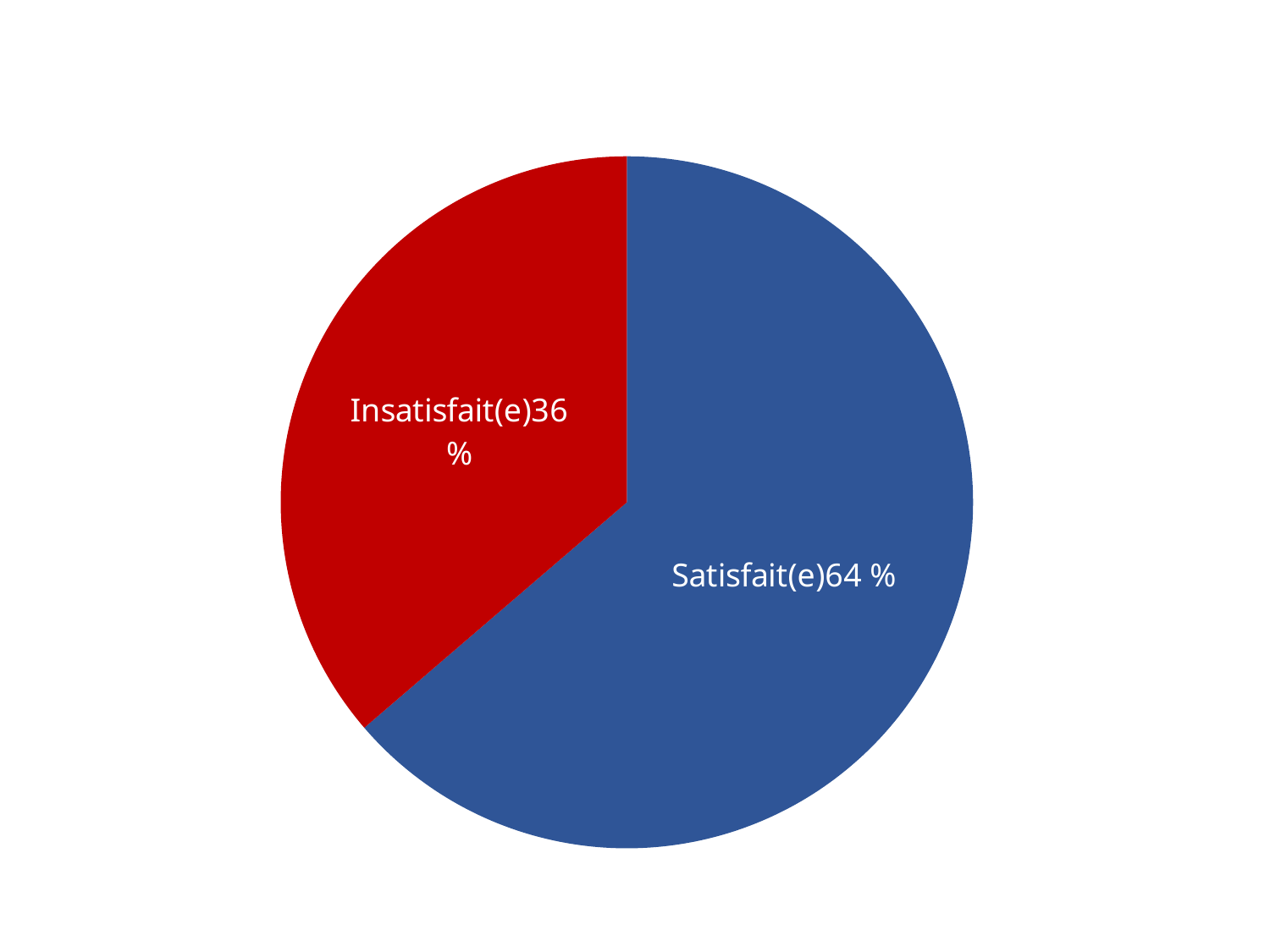
What share of the pie does Satisfait(e) represent? 64 % What is the difference in percentage points between Satisfait(e) and Insatisfait(e)? 28 What colour is the Satisfait(e) slice? blue What kind of chart is shown on the slide? pie chart Which is larger, the Satisfait(e) slice or the Insatisfait(e) slice? Satisfait(e) Which slice is the largest? Satisfait(e) Which slice is the smallest? Insatisfait(e) What share of the pie does Insatisfait(e) represent? 36 % How many slices does the pie chart have? 2 What colour is the Insatisfait(e) slice? red